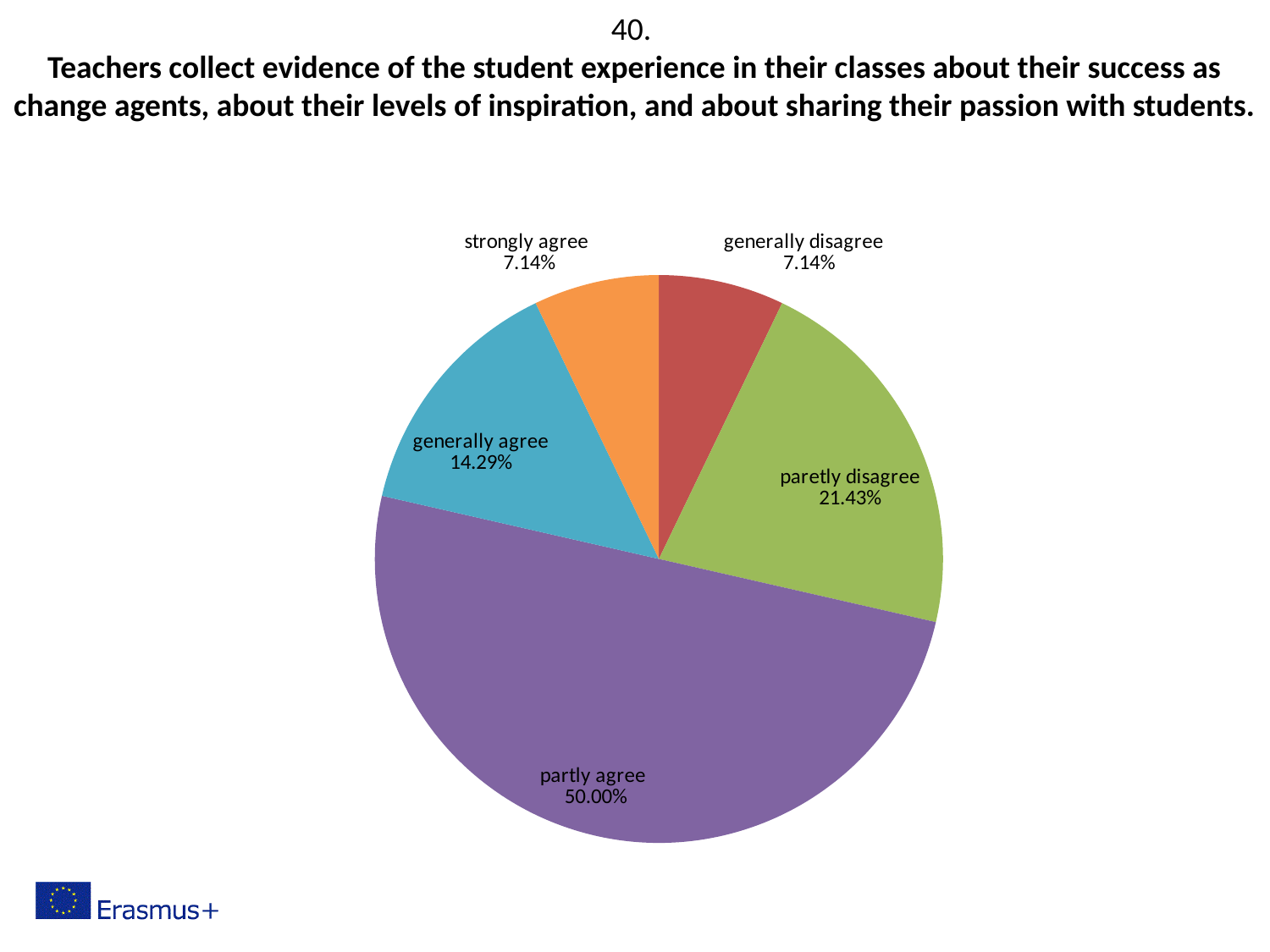
Which two response categories have the same share of 7.14%? strongly agree and generally disagree What percentage of respondents chose "strongly agree"? 7.14% How many slices does the pie chart have? 5 What is the difference between the "partly agree" share and the "paretly disagree" share? 28.57% Which is larger, the share for "generally agree" or the share for "paretly disagree"? paretly disagree What kind of chart is shown on the slide? pie chart Which response category has the largest share of the pie? partly agree What colour is the "partly agree" slice? purple What percentage of respondents chose "partly agree"? 50.00% What percentage of respondents chose "generally agree"? 14.29% What is the difference between the "generally agree" share and the "strongly agree" share? 7.15% What percentage of respondents chose "paretly disagree"? 21.43%